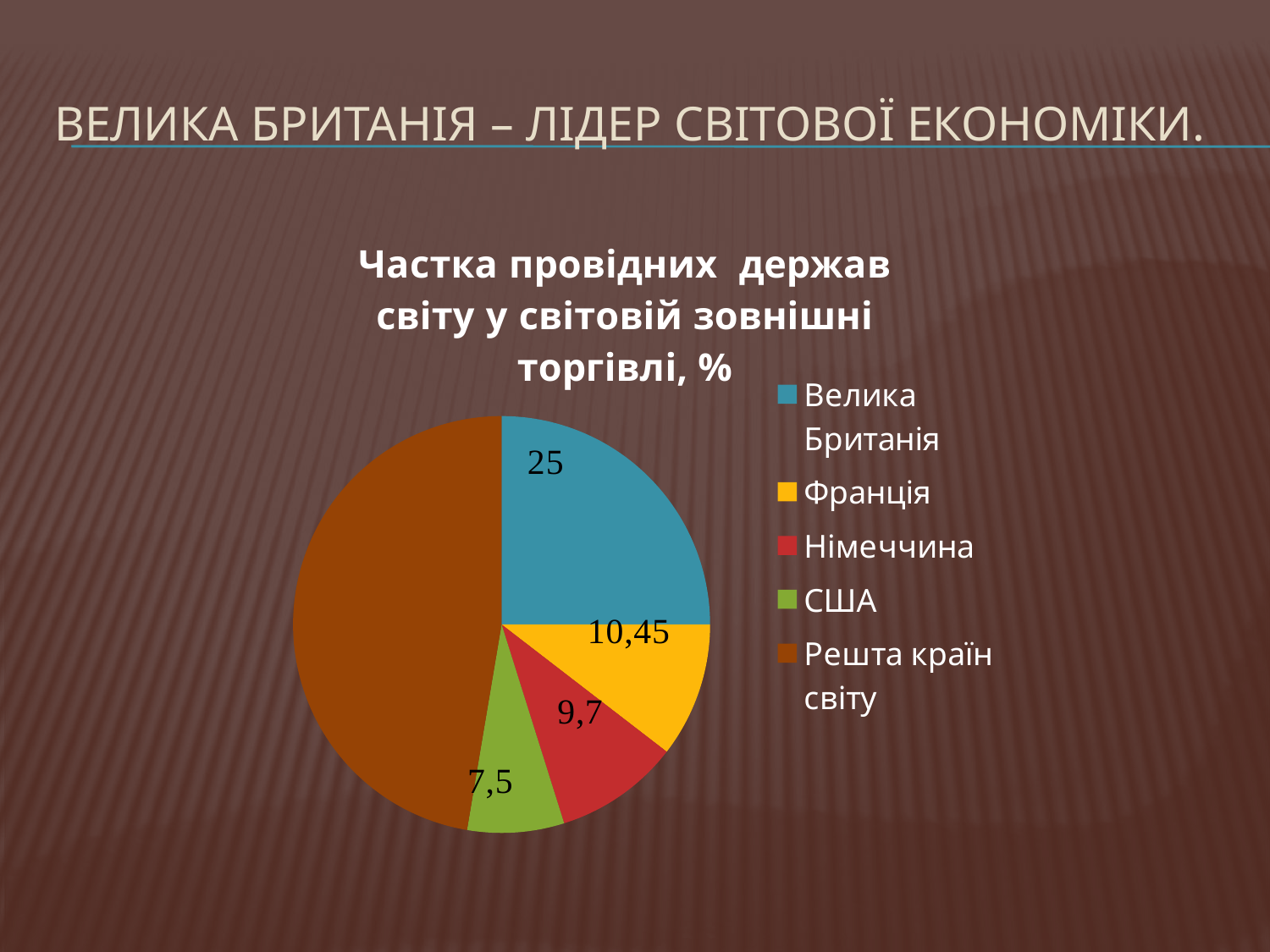
Which is larger, the value for Франція or the value for Німеччина? Франція How many categories does the pie chart have? 5 What is the value for Франція? 10,45 What is the value for Німеччина? 9,7 Which category has the smallest slice of the pie? США What type of chart is shown on the slide? pie chart What colour is the slice for Велика Британія? blue What is the value for США? 7,5 What is the difference between the values for Німеччина and США? 2,2 Which category has the largest slice of the pie? Решта країн світу What is the difference between the values for Велика Британія and Франція? 14,55 What is the value for Велика Британія? 25